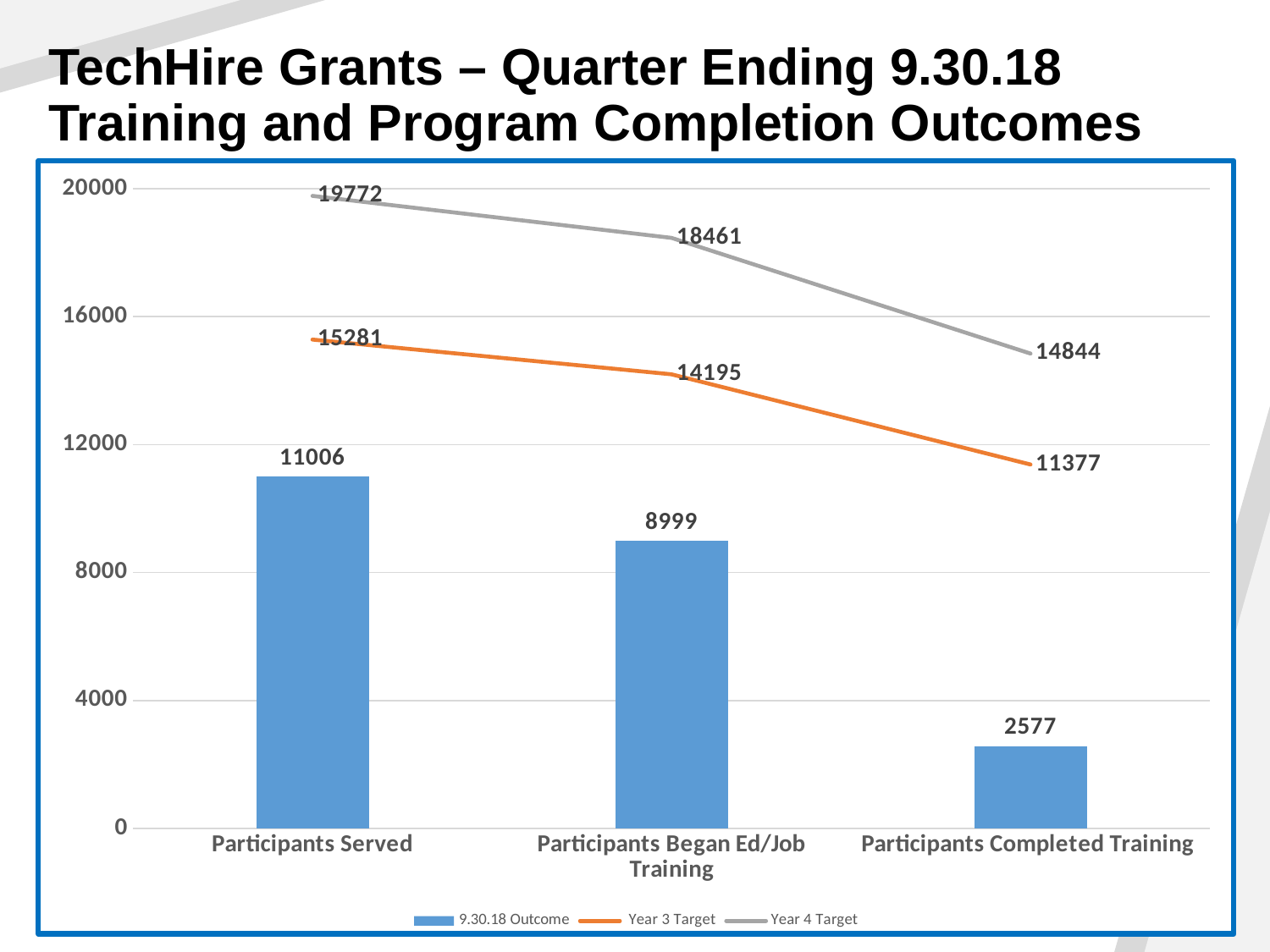
Which category has the highest Year 4 Target? Participants Served What is the Year 4 Target for Participants Began Ed/Job Training? 18461 Which series is shown as bars rather than lines? 9.30.18 Outcome Do the Year 4 Target values rise or fall from left to right across the categories? fall What is the 9.30.18 Outcome value for Participants Served? 11006 Is the 9.30.18 Outcome for Participants Completed Training greater or less than 4000? less Which category has the lowest 9.30.18 Outcome value? Participants Completed Training Which is larger for Participants Served: the Year 3 Target or the 9.30.18 Outcome? Year 3 Target What is the difference between the Year 3 Target and the 9.30.18 Outcome for Participants Began Ed/Job Training? 5196 How many series does the legend list? 3 How many categories are shown on the x axis? 3 What is the Year 3 Target for Participants Completed Training? 11377